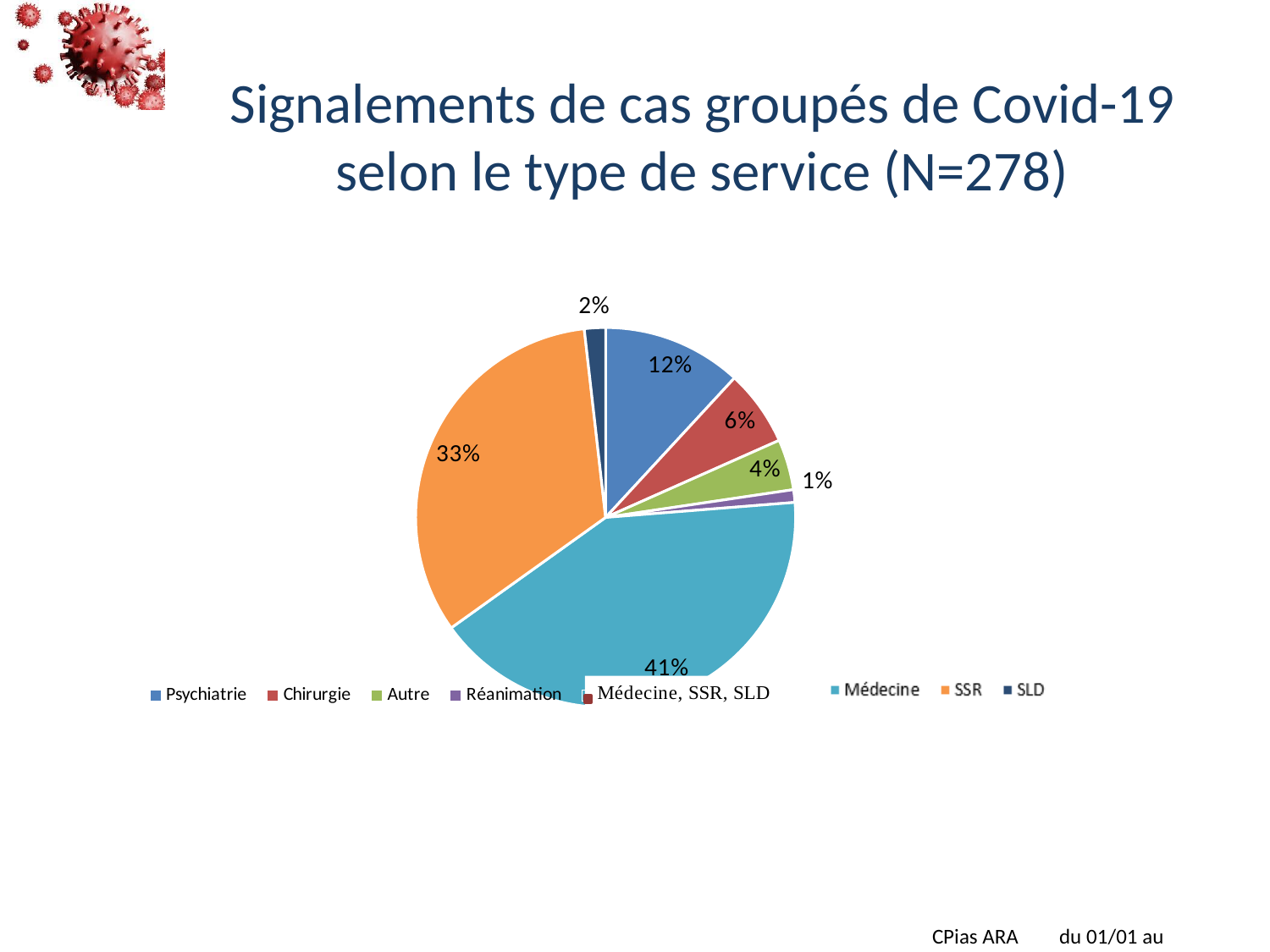
Which type of service has the largest share of the pie? Médecine What share of the pie does SLD represent? 2% What share of the pie does Médecine represent? 41% What is the difference in percentage points between the Médecine and SSR shares? 8 What is the total number of reports (N) given in the chart title? 278 What share of the pie does Chirurgie represent? 6% What share of the pie does Psychiatrie represent? 12% What share of the pie does SSR represent? 33% Which has a larger share, Psychiatrie or Chirurgie? Psychiatrie What share of the pie does Réanimation represent? 1% What kind of chart is shown on the slide? pie chart Which type of service has the smallest share of the pie? Réanimation